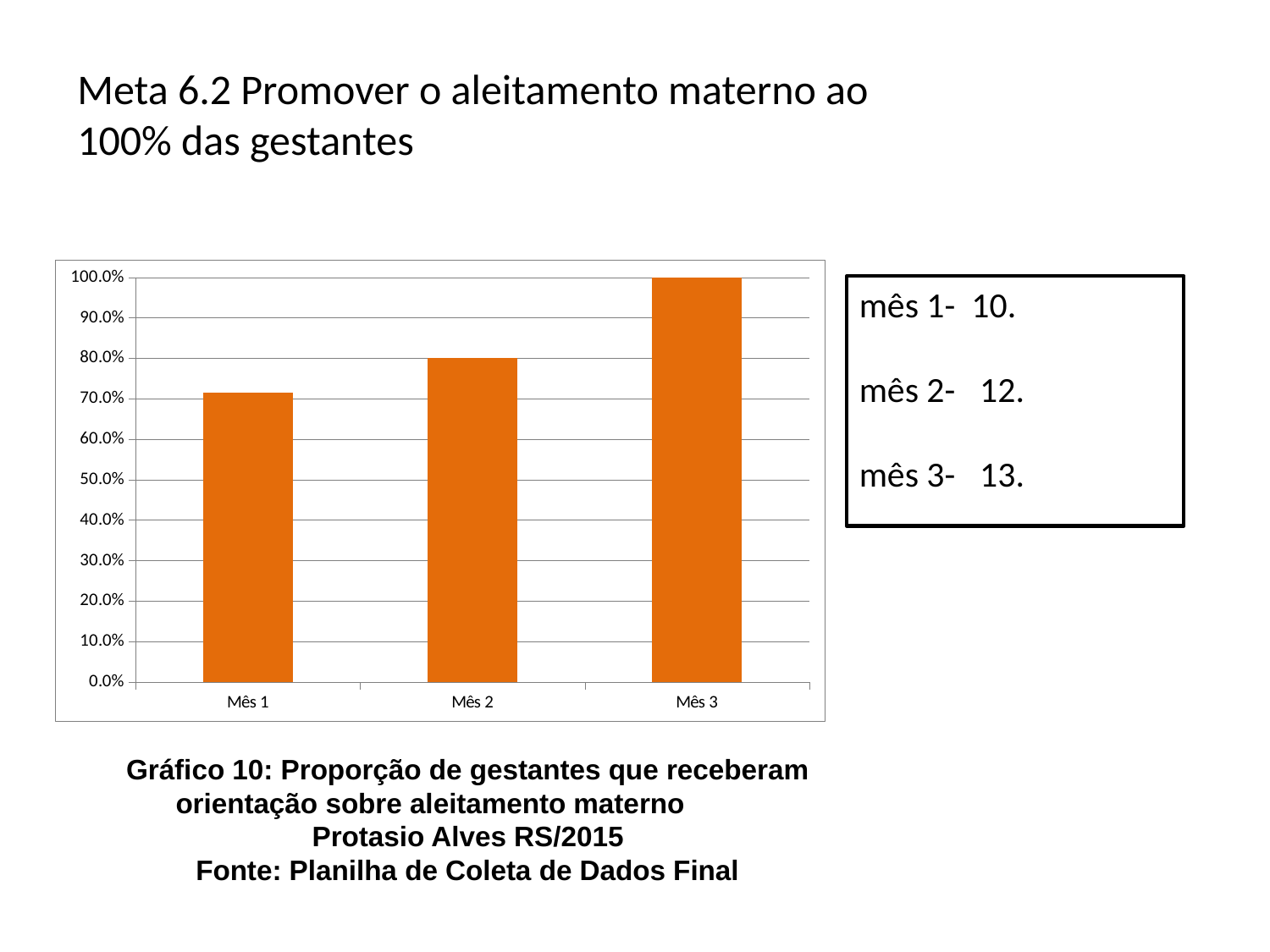
Do the values rise or fall from Mês 1 to Mês 3? rise What is the value for Mês 2? 80.0% Is the value for Mês 1 greater or less than 80.0%? less Which month has the highest value in the chart? Mês 3 Is the value for Mês 1 greater or less than 70.0%? greater What is the difference between the values for Mês 3 and Mês 2? 20.0% Which month has the lowest value in the chart? Mês 1 Which is larger, the value for Mês 1 or the value for Mês 2? Mês 2 What kind of chart is shown on the slide? bar chart What is the value for Mês 3? 100.0% What colour are the bars in the chart? orange How many bars (categories) does the chart show? 3